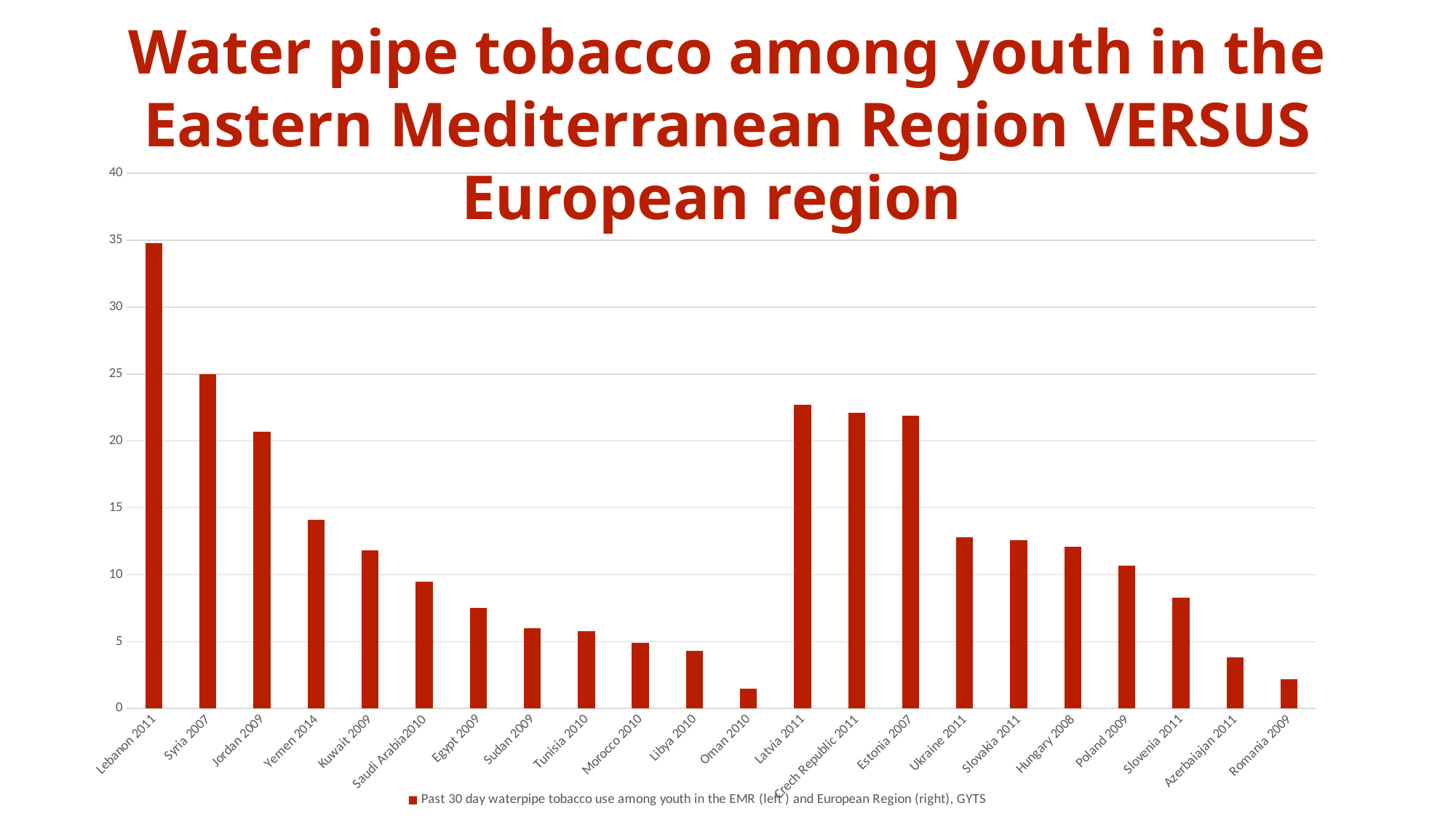
Do the values for the Eastern Mediterranean countries (Lebanon 2011 through Oman 2010) rise or fall from left to right? fall Which is larger, the value for Syria 2007 or the value for Czech Republic 2011? Syria 2007 Is the value for Lebanon 2011 greater or less than 30? greater Is the value for Latvia 2011 greater or less than 20? greater How many country-year categories are plotted on the chart? 22 Is the value for Azerbaijan 2011 greater or less than 5? less Which is larger, the value for Hungary 2008 or the value for Poland 2009? Hungary 2008 How many series does the legend list? 1 Which category has the highest bar on the chart? Lebanon 2011 What kind of chart is shown on the slide? bar chart